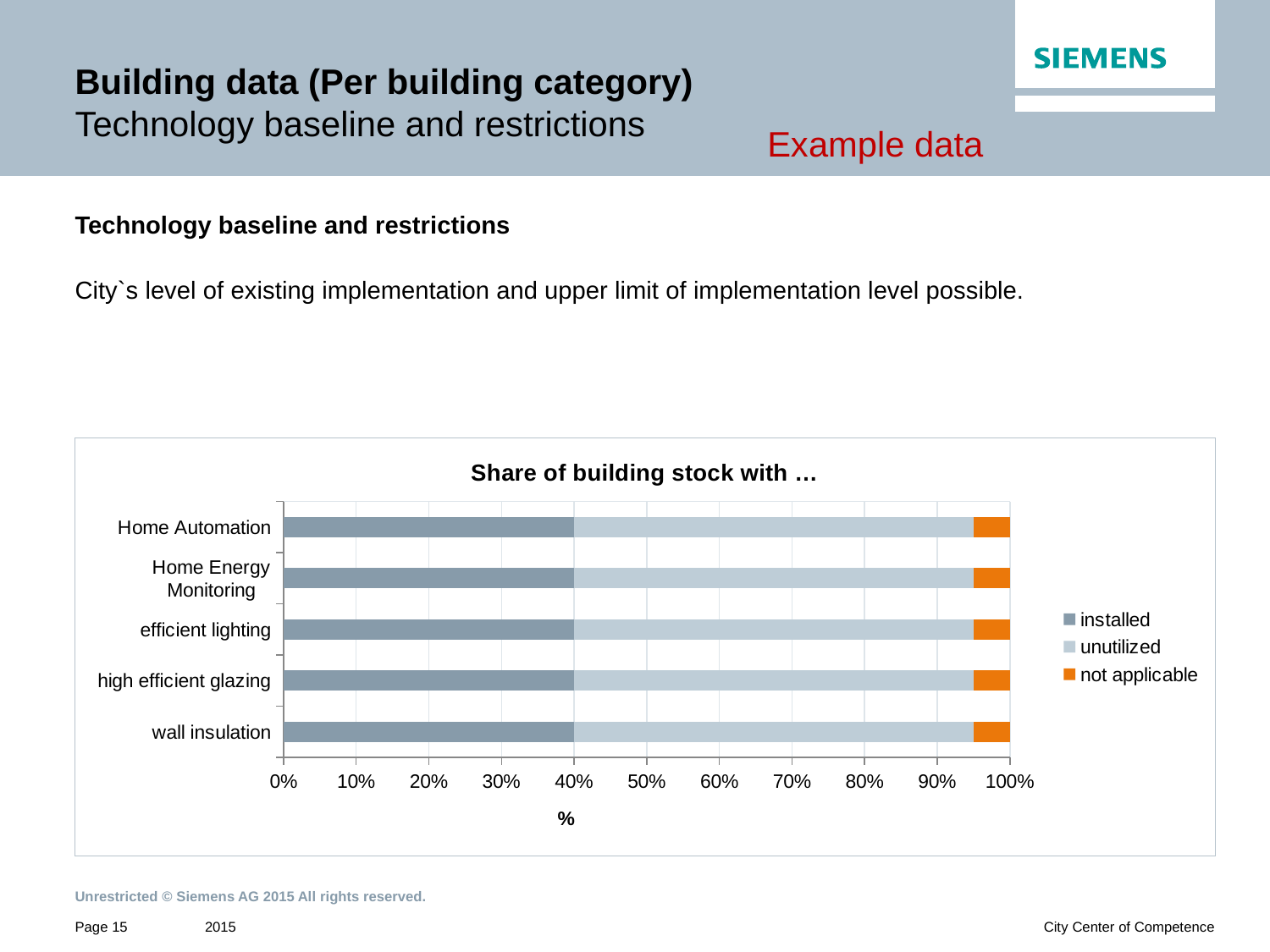
What kind of chart is shown on the slide? stacked bar chart How many series does the legend list? 3 Is the unutilized share for high efficient glazing greater or less than 50%? greater What is the installed share for Home Automation? 40% For wall insulation, which is larger: the installed share or the not applicable share? installed Is the not applicable share for efficient lighting greater or less than 10%? less What label is shown on the horizontal axis? % How many building technology categories are shown on the chart? 5 What is the total of the stacked bar for Home Energy Monitoring? 100% What is the installed share for wall insulation? 40% Which series is shown in orange in the legend? not applicable What is the title of the chart? Share of building stock with …